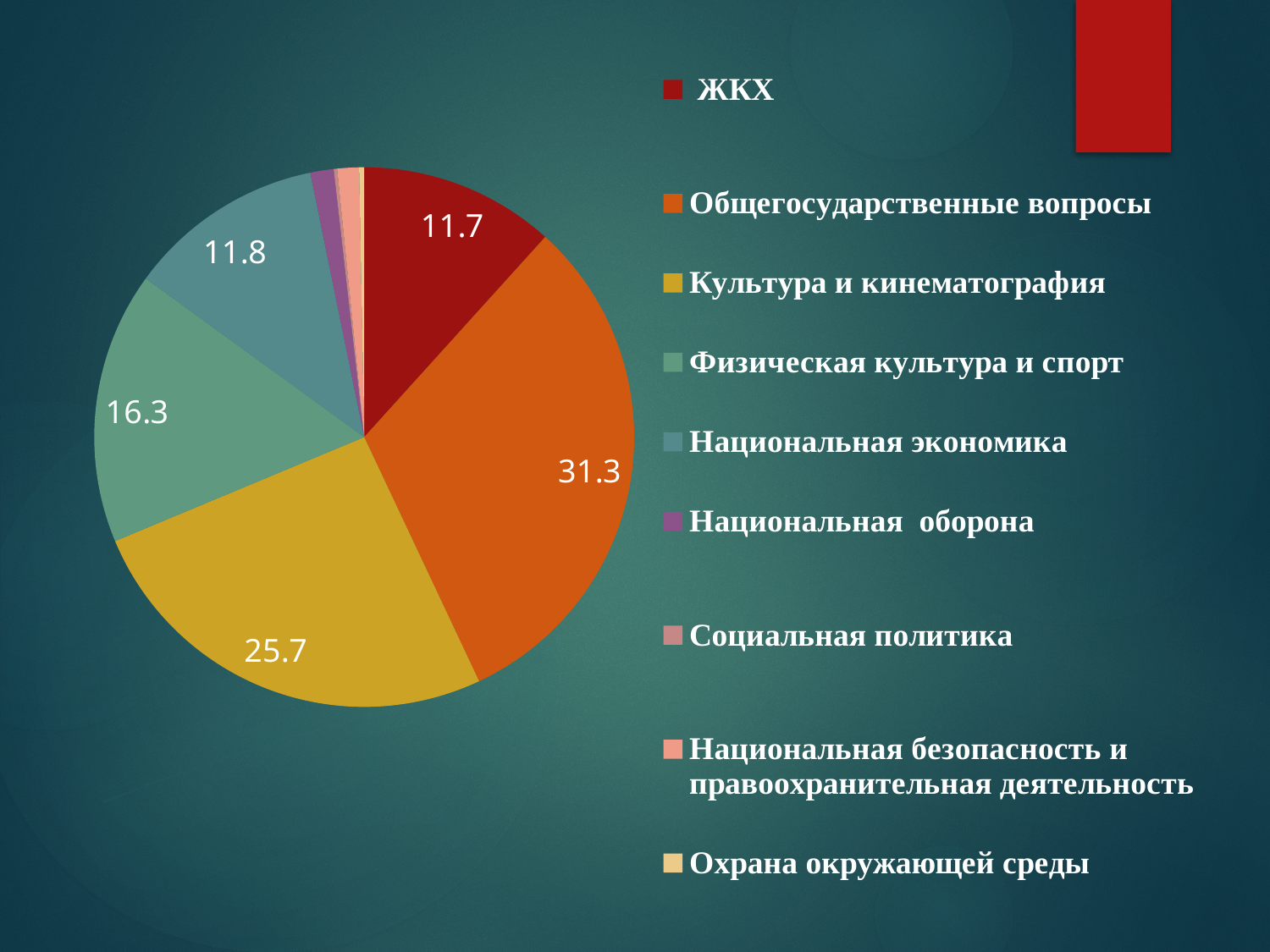
Which category has the largest slice of the pie? Общегосударственные вопросы What type of chart is shown on the slide? pie chart What is the value shown for Национальная экономика? 11.8 What is the value shown for Общегосударственные вопросы? 31.3 What is the difference between the values for Общегосударственные вопросы and Культура и кинематография? 5.6 What is the value shown for ЖКХ? 11.7 What is the value shown for Культура и кинематография? 25.7 How many categories does the legend list? 9 Which is larger, the value for Физическая культура и спорт or the value for Национальная экономика? Физическая культура и спорт What is the value shown for Физическая культура и спорт? 16.3 What colour is the slice for ЖКХ? dark red